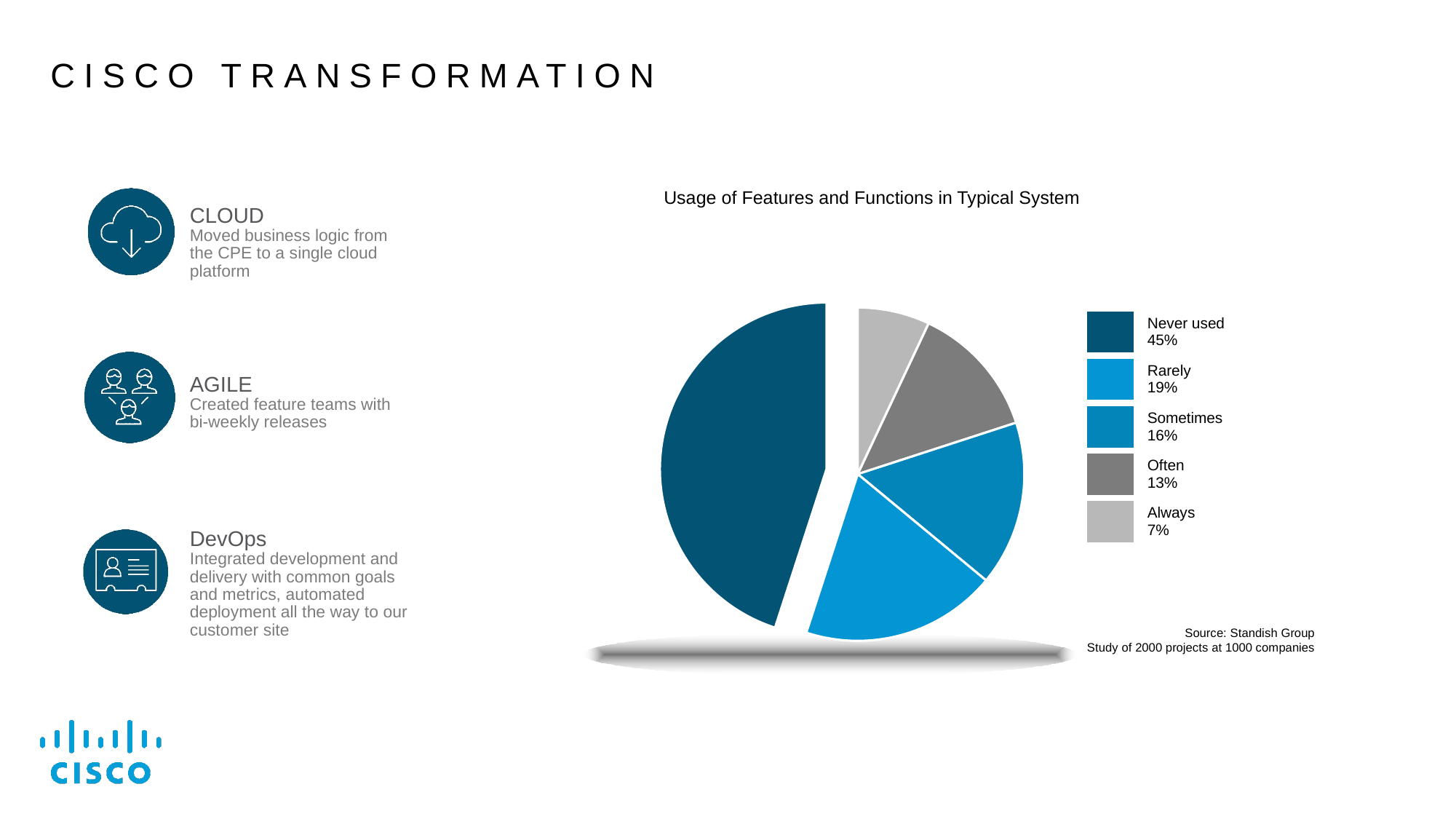
What percentage is shown for "Always"? 7% Which category has the largest slice of the pie? Never used Which category has the smallest slice of the pie? Always What percentage is shown for "Rarely"? 19% Which is larger, the share for "Often" or the share for "Sometimes"? Sometimes What kind of chart is shown on the slide? pie chart What percentage is shown for "Sometimes"? 16% What share of the pie is labelled "Never used"? 45% What is the source cited for the chart data? Standish Group How many categories does the pie chart have? 5 What is the difference between the "Never used" and "Rarely" percentages? 26% What is the title of the chart? Usage of Features and Functions in Typical System